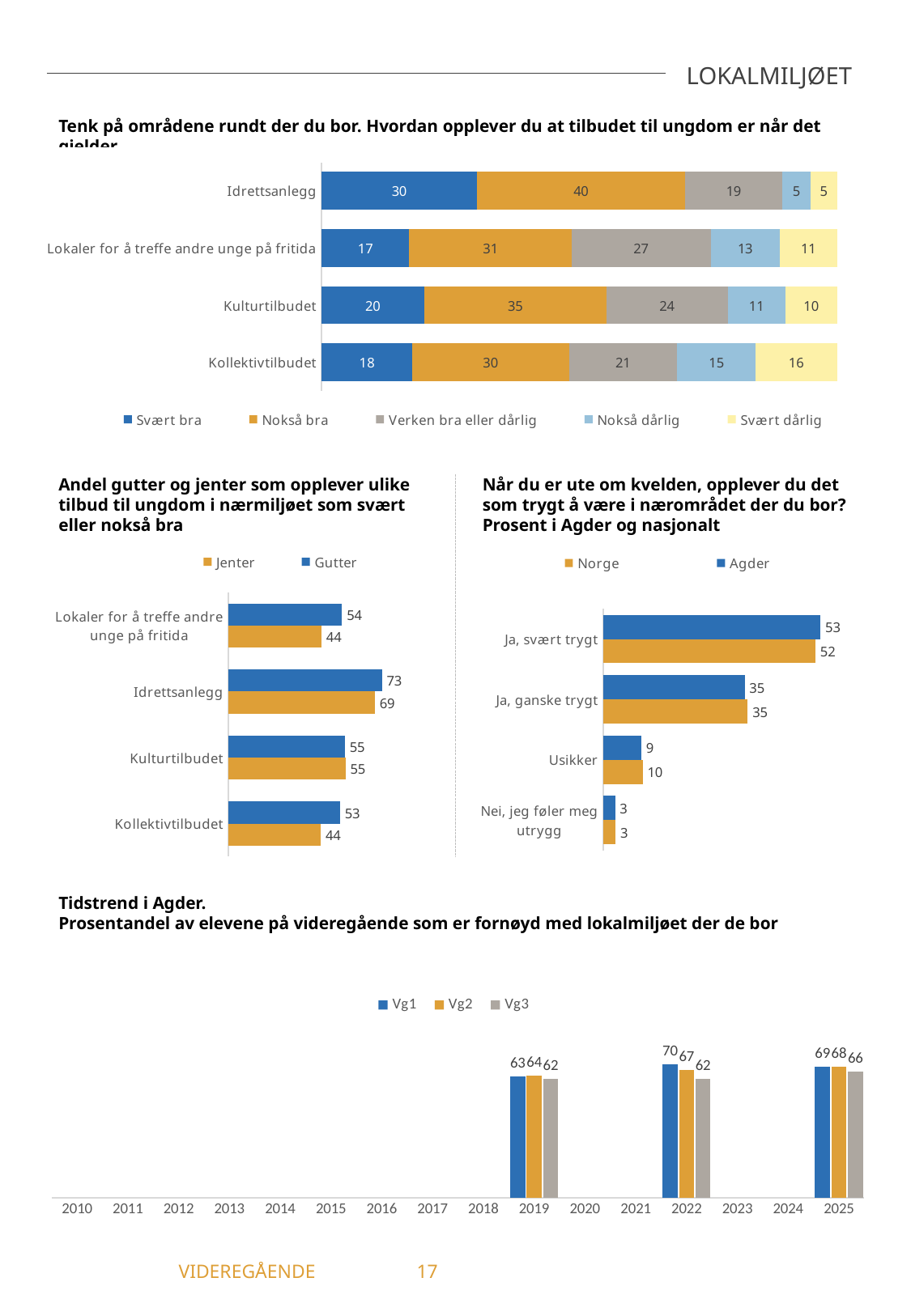
In the chart "Tidstrend i Agder", what is the value for Vg3 in 2025? 66 In the top stacked bar chart about the offer for young people, what is the value for "Svært dårlig" for Kollektivtilbudet? 16 In the chart "Når du er ute om kvelden, opplever du det som trygt...", which is larger for "Ja, svært trygt": Agder or Norge? Agder In the top stacked bar chart about the offer for young people, what is the total of the bar for Kulturtilbudet? 100 In the top stacked bar chart about the offer for young people ("Tenk på områdene rundt der du bor..."), what is the value for "Svært bra" for Idrettsanlegg? 30 In the chart "Når du er ute om kvelden, opplever du det som trygt...", what is the value for Norge for "Usikker"? 10 In the chart "Tidstrend i Agder", what is the value for Vg1 in 2022? 70 In the top stacked bar chart about the offer for young people, how many series does the legend list? 5 What kind of chart is the "Tidstrend i Agder" chart at the bottom of the slide? Bar chart In the chart "Andel gutter og jenter som opplever ulike tilbud...", what is the difference between Gutter and Jenter for Kollektivtilbudet? 9 In the chart "Andel gutter og jenter som opplever ulike tilbud...", which category has the highest value for Jenter? Idrettsanlegg In the chart "Andel gutter og jenter som opplever ulike tilbud til ungdom i nærmiljøet som svært eller nokså bra", what is the value for Gutter for Idrettsanlegg? 73